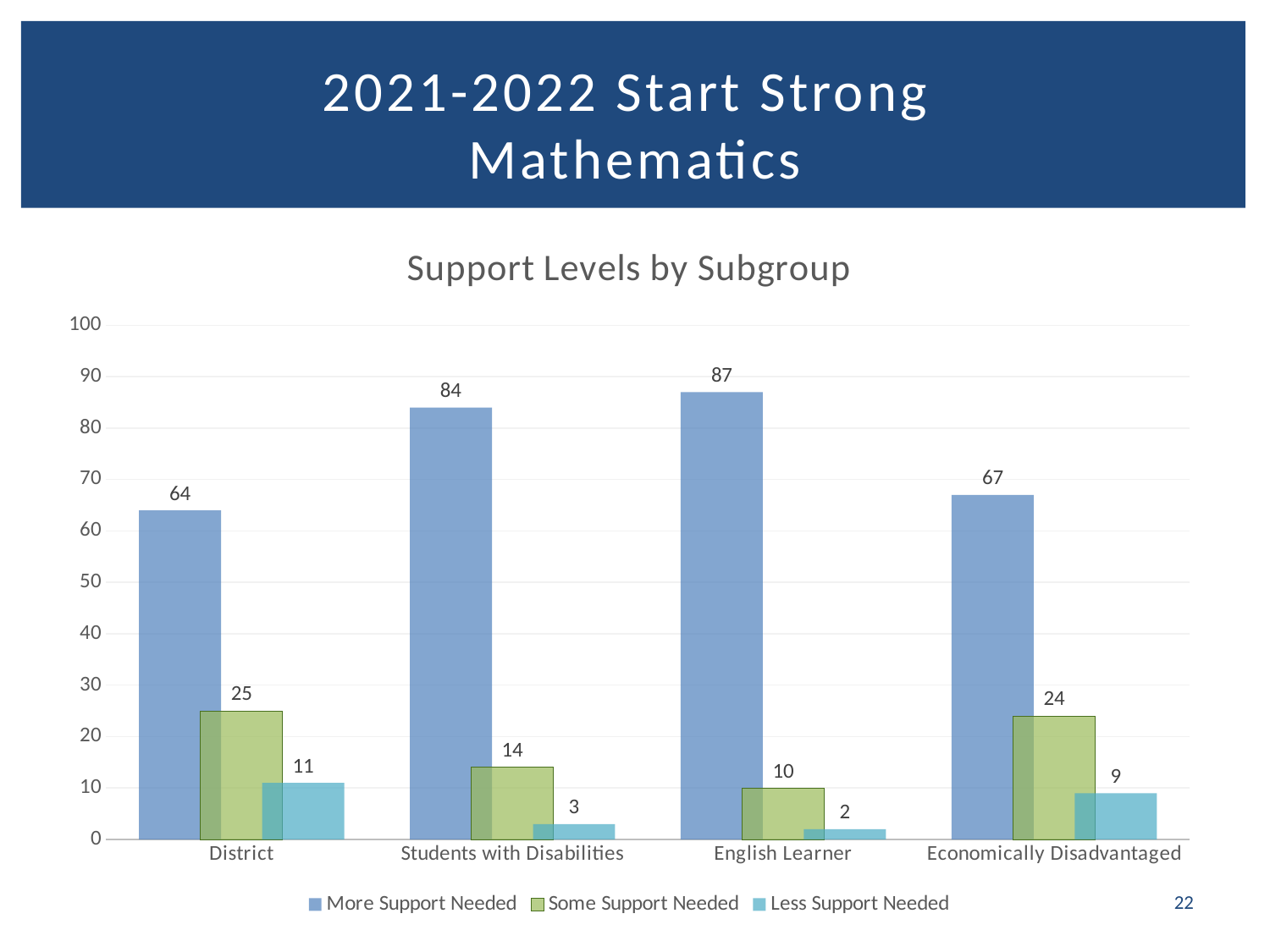
What kind of chart is shown? bar chart How many subgroups are shown on the x axis? 4 What is the value for Some Support Needed for District? 25 What is the value for More Support Needed for English Learner? 87 How many series does the legend list? 3 Which subgroup has the lowest value for Less Support Needed? English Learner What is the value for Less Support Needed for Students with Disabilities? 3 Is the value for More Support Needed for Economically Disadvantaged greater or less than 70? less What is the title of the chart? Support Levels by Subgroup Which is larger: Some Support Needed for District or Some Support Needed for Economically Disadvantaged? District What is the difference between the More Support Needed values for Students with Disabilities and District? 20 Which subgroup has the highest value for More Support Needed? English Learner